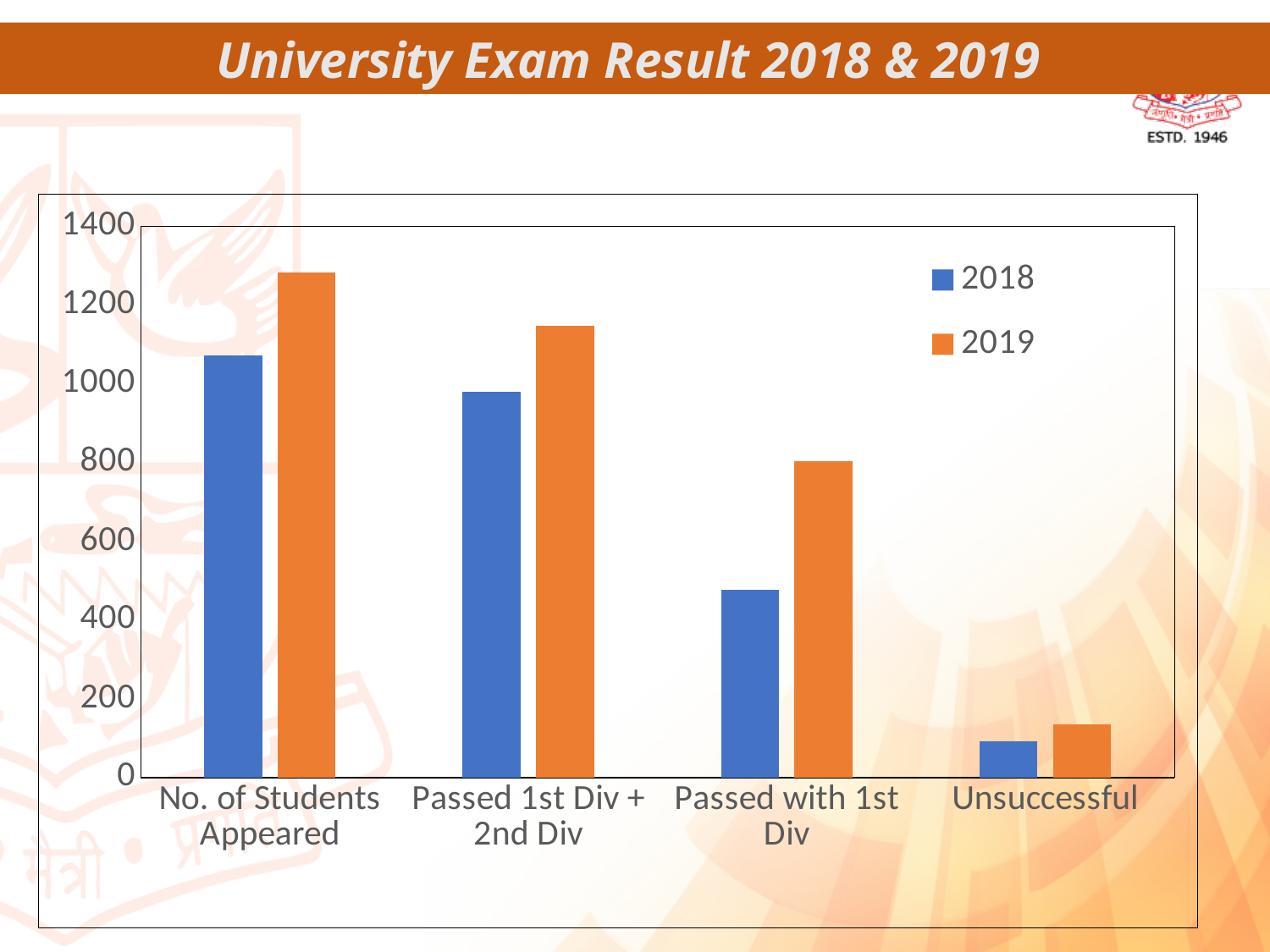
Is the 2018 value for Passed with 1st Div greater or less than 600? less How many categories are shown on the x axis? 4 What kind of chart is shown on the slide? bar chart Which category has the lowest 2018 value? Unsuccessful Is the 2019 value for No. of Students Appeared greater or less than 1200? greater What is the title of the chart? University Exam Result 2018 & 2019 Which category has the highest 2019 value? No. of Students Appeared Is the 2019 value for Passed 1st Div + 2nd Div greater or less than 1000? greater How many series does the legend list? 2 For Passed with 1st Div, which year has the larger value, 2018 or 2019? 2019